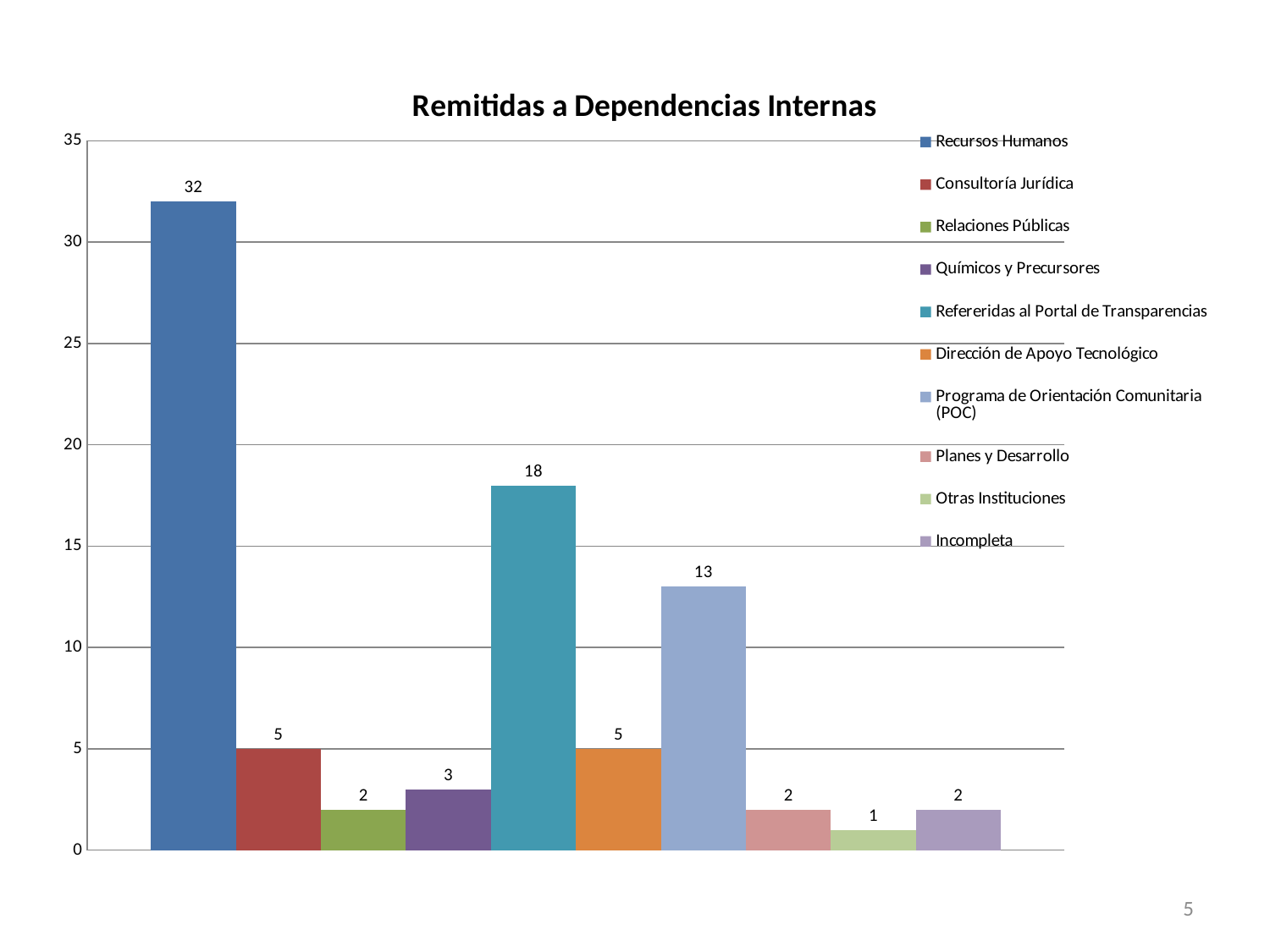
What is the value for Químicos y Precursores? 3 How many series does the legend list? 10 What is the difference between the values for Recursos Humanos and Refereridas al Portal de Transparencias? 14 What kind of chart is shown on the slide? Bar chart What is the value for Recursos Humanos? 32 Which is larger, the value for Programa de Orientación Comunitaria (POC) or the value for Consultoría Jurídica? Programa de Orientación Comunitaria (POC) Is the value for Refereridas al Portal de Transparencias greater or less than 15? greater What is the title of the chart? Remitidas a Dependencias Internas What is the value for Programa de Orientación Comunitaria (POC)? 13 Which series has the lowest value? Otras Instituciones Which series has the highest value? Recursos Humanos What is the value for Refereridas al Portal de Transparencias? 18